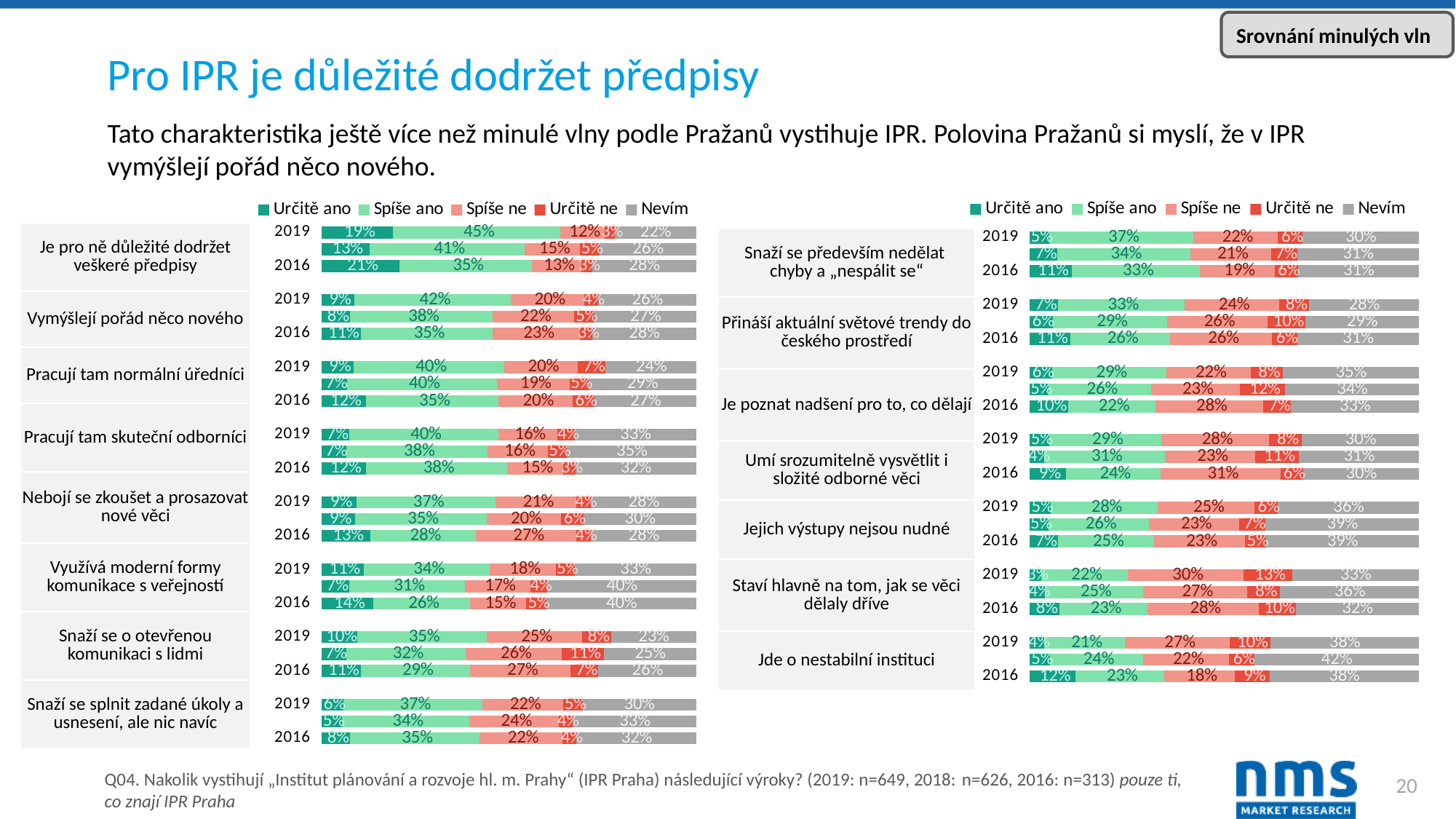
In the left chart, what percentage answered "Spíše ano" for "Je pro ně důležité dodržet veškeré předpisy" in 2019? 45% In the left chart, which statement has the highest "Spíše ano" share in 2019? Je pro ně důležité dodržet veškeré předpisy How many series does the legend of the left chart list? 5 What kind of chart is used on this slide? Stacked bar chart In the right chart, what percentage answered "Určitě ano" for "Jde o nestabilní instituci" in 2016? 12% What is the first entry in the legend of the right chart? Určitě ano In the left chart, for "Je pro ně důležité dodržet veškeré předpisy", was the "Určitě ano" share larger in 2019 or in 2016? 2016 In the left chart, what percentage answered "Spíše ne" for "Snaží se o otevřenou komunikaci s lidmi" in 2019? 25% In the right chart, what percentage answered "Určitě ne" for "Staví hlavně na tom, jak se věci dělaly dříve" in 2019? 13% How many statements are shown in the left chart? 8 In the left chart, what is the difference in the "Nevím" share for "Využívá moderní formy komunikace s veřejností" between 2016 and 2019? 7 percentage points How many statements are shown in the right chart? 7